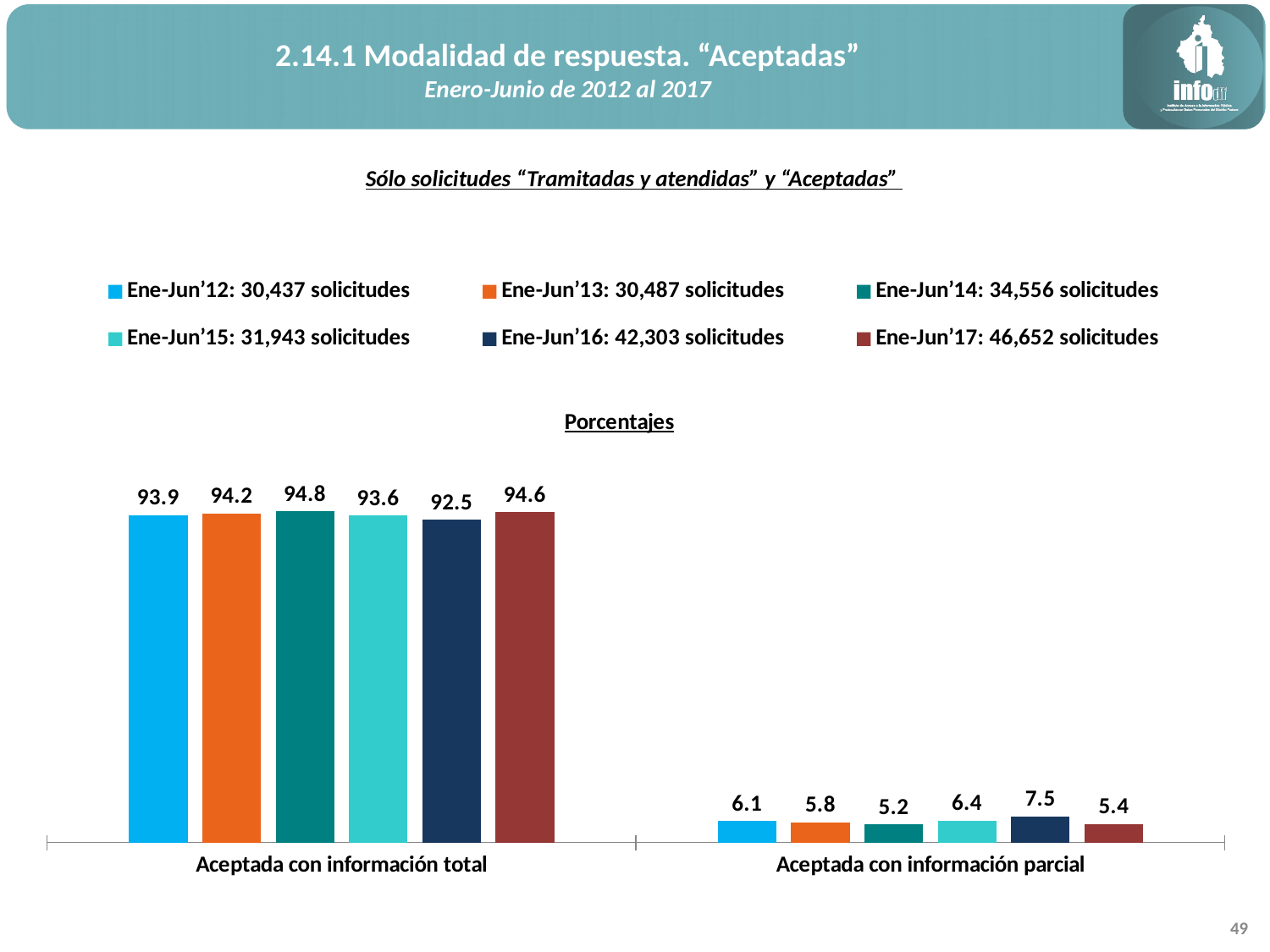
What is the value for Ene-Jun'14 in the "Aceptada con información total" category? 94.8 What kind of chart is shown on the slide? Bar chart How many categories are shown on the x axis? 2 How many series does the legend list? 6 According to the legend, how many solicitudes does Ene-Jun'17 correspond to? 46,652 solicitudes What is the value for Ene-Jun'16 in the "Aceptada con información parcial" category? 7.5 What is the value for Ene-Jun'12 in the "Aceptada con información total" category? 93.9 What is the difference between the Ene-Jun'14 and Ene-Jun'16 values in the "Aceptada con información total" category? 2.3 Which series has the highest value in the "Aceptada con información total" category? Ene-Jun'14 What is the difference between the Ene-Jun'16 and Ene-Jun'14 values in the "Aceptada con información parcial" category? 2.3 Which is larger in the "Aceptada con información parcial" category: Ene-Jun'15 or Ene-Jun'17? Ene-Jun'15 Which series has the lowest value in the "Aceptada con información parcial" category? Ene-Jun'14